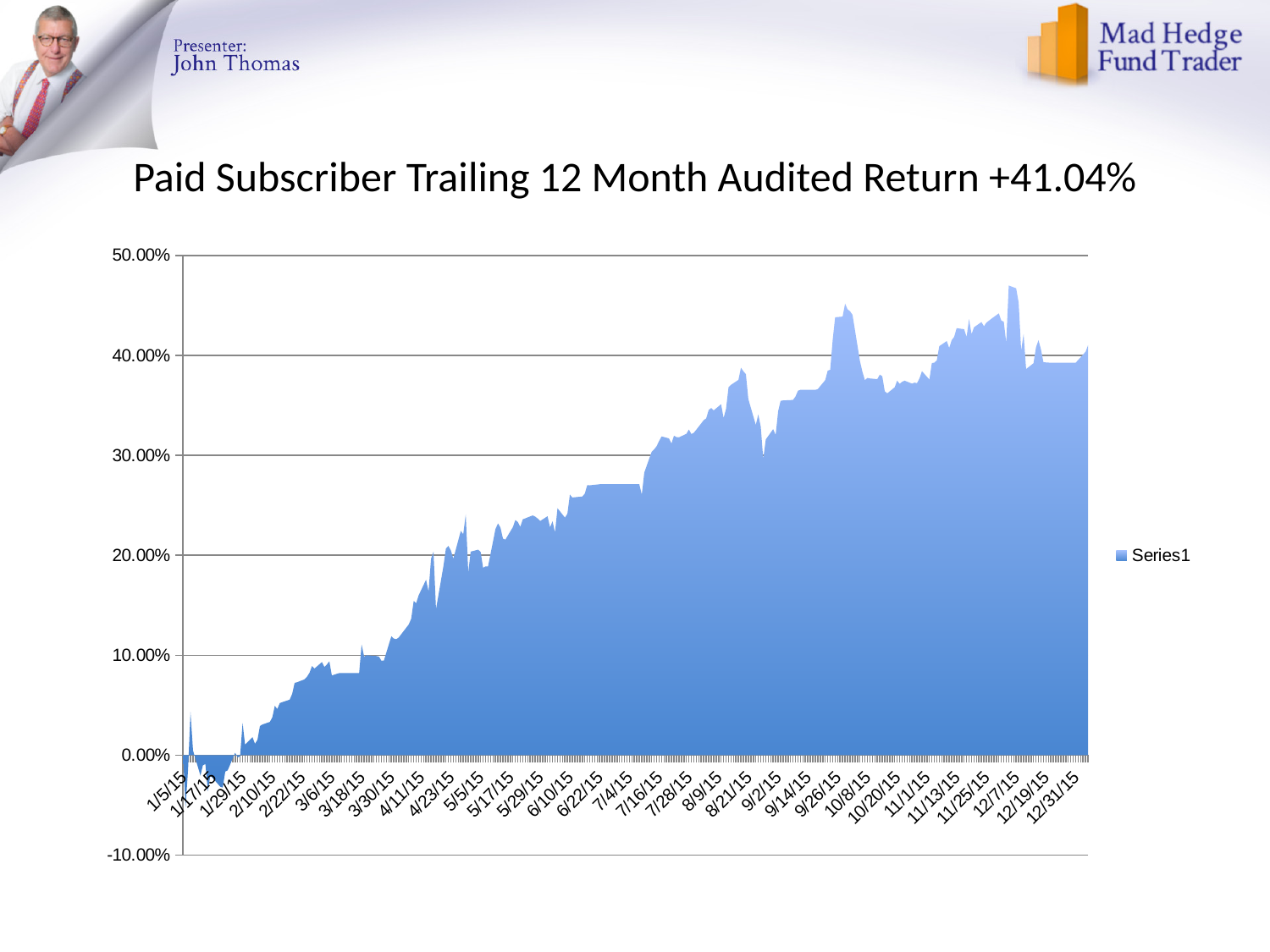
Is the value for 9/26/15 greater or less than 40.00%? greater What kind of chart is shown on the slide? area chart Is the value for 12/31/15 greater or less than 30.00%? greater Is the value for 5/29/15 greater or less than 20.00%? greater What is the highest value shown on the y axis? 50.00% What is the first date label on the x axis? 1/5/15 Do the values generally rise or fall from left to right along the x axis? rise How many series does the legend list? 1 What is the name of the series shown in the legend? Series1 What is the title of the chart on the slide? Paid Subscriber Trailing 12 Month Audited Return +41.04%